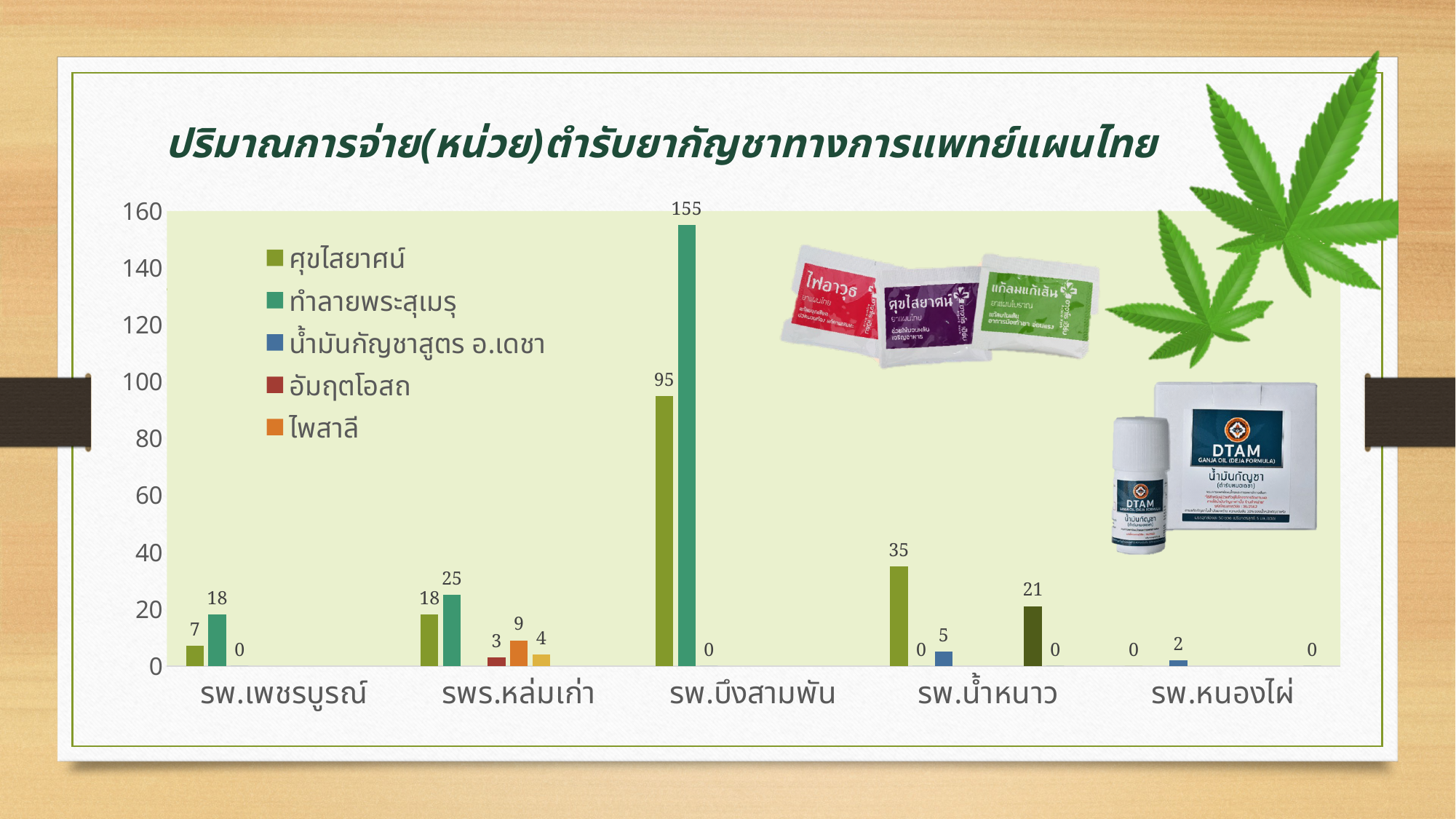
At รพร.หล่มเก่า, which is larger: ศุขไสยาศน์ or ทำลายพระสุเมรุ? ทำลายพระสุเมรุ What is the value of น้ำมันกัญชาสูตร อ.เดชา for รพ.หนองไผ่? 2 Which hospital has the highest value for ศุขไสยาศน์? รพ.บึงสามพัน What is the value of ศุขไสยาศน์ for รพ.น้ำหนาว? 35 Which hospital has the highest value for ทำลายพระสุเมรุ? รพ.บึงสามพัน At รพ.เพชรบูรณ์, what is the difference between ทำลายพระสุเมรุ and ศุขไสยาศน์? 11 What is the value of ทำลายพระสุเมรุ for รพ.บึงสามพัน? 155 What is the value of อัมฤตโอสถ for รพร.หล่มเก่า? 3 How many series does the legend list? 5 At รพ.บึงสามพัน, what is the difference between ทำลายพระสุเมรุ and ศุขไสยาศน์? 60 What is the value of ไพสาลี for รพร.หล่มเก่า? 9 How many hospitals are shown on the x axis? 5